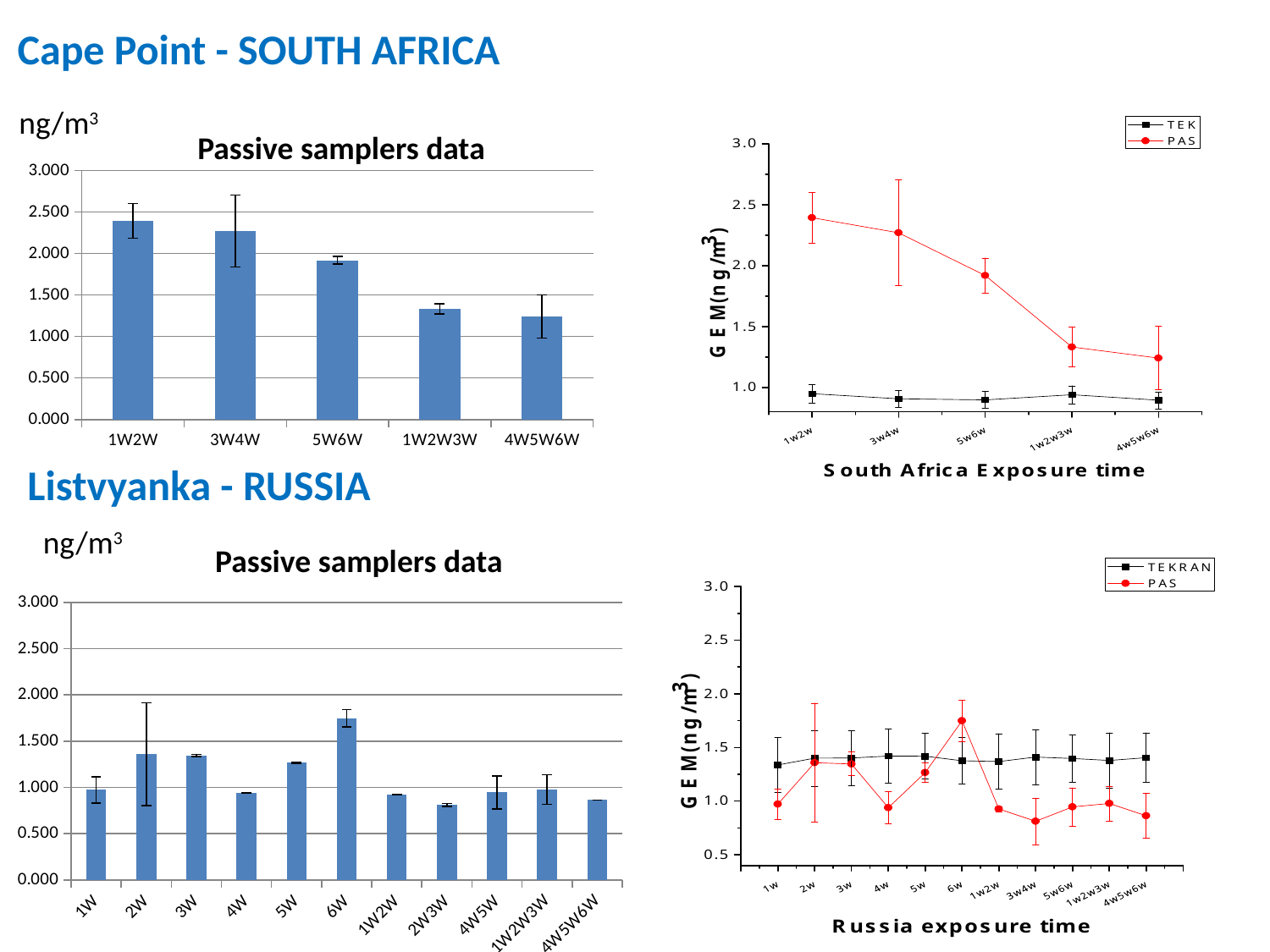
How many series does the legend list in the line chart with the x-axis title 'South Africa Exposure time'? 2 What are the two legend entries in the chart with the x-axis title 'Russia exposure time'? TEKRAN and PAS What kind of chart is the 'Passive samplers data' chart under Cape Point - SOUTH AFRICA? bar chart What kind of chart is the chart with the x-axis title 'Russia exposure time'? line chart In the Listvyanka - RUSSIA 'Passive samplers data' bar chart, which is larger, the value for 3W or the value for 4W? 3W In the Listvyanka - RUSSIA 'Passive samplers data' bar chart, is the value for 4W greater or less than 1.000? less In the Cape Point - SOUTH AFRICA 'Passive samplers data' bar chart, do the values generally rise or fall from left to right along the x axis? fall In the Listvyanka - RUSSIA 'Passive samplers data' bar chart, which category has the highest value? 6W In the Cape Point - SOUTH AFRICA 'Passive samplers data' bar chart, how many categories are shown on the x axis? 5 In the Listvyanka - RUSSIA 'Passive samplers data' bar chart, how many categories are shown on the x axis? 11 In the Cape Point - SOUTH AFRICA 'Passive samplers data' bar chart, is the value for 5W6W greater or less than 1.500? greater In the Cape Point - SOUTH AFRICA 'Passive samplers data' bar chart, is the value for 1W2W3W greater or less than 1.500? less